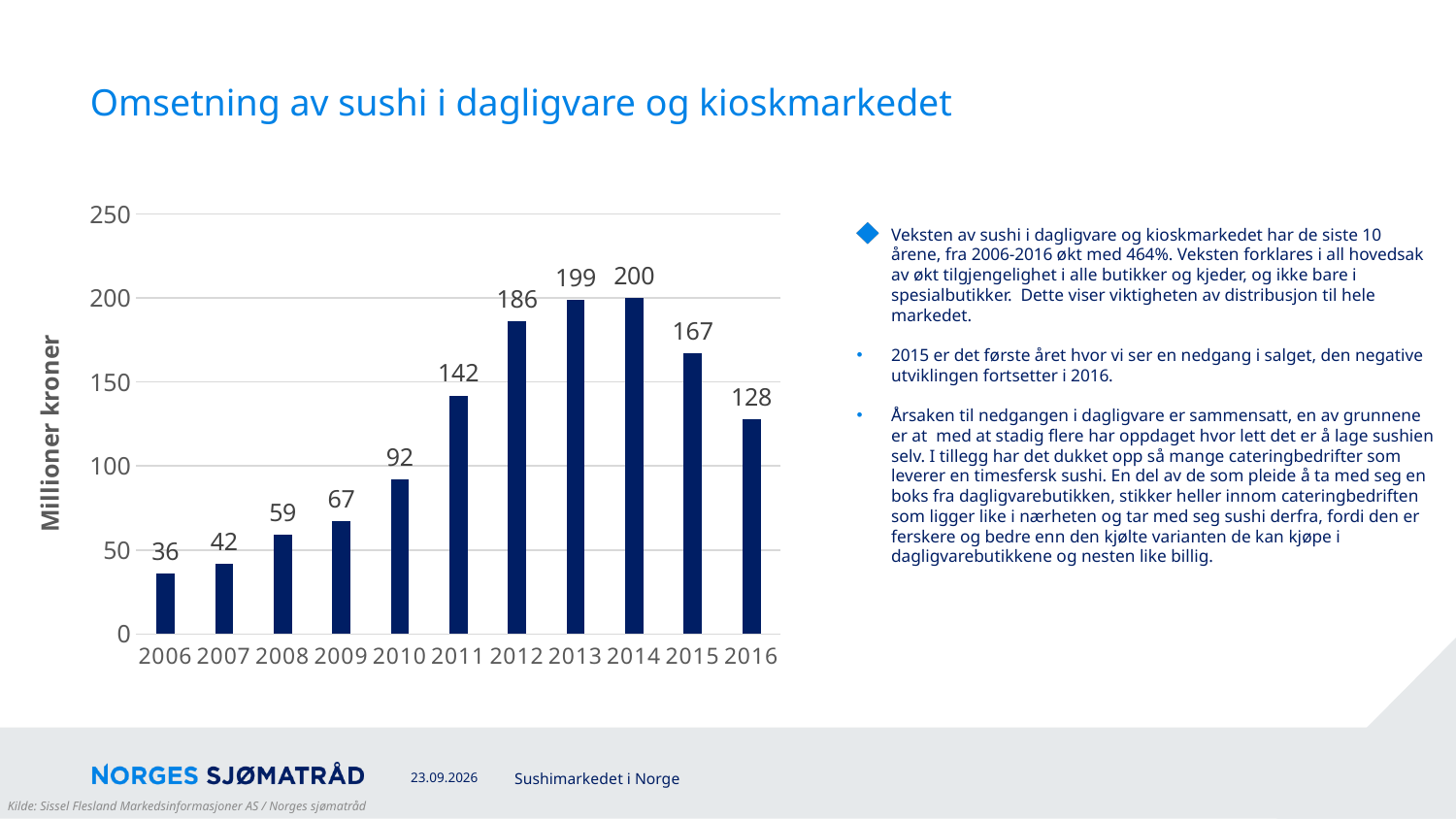
How many years are shown on the x axis? 11 What is the label of the y axis? Millioner kroner Is the value for 2009 greater or less than 100? less What is the difference between the values for 2011 and 2010? 50 What is the value for 2016? 128 Which year has the lowest value? 2006 What is the value for 2012? 186 Which is larger, the value for 2015 or the value for 2011? 2015 What is the value for 2006? 36 What is the difference between the values for 2014 and 2016? 72 What kind of chart is shown on the slide? bar chart Which year has the highest value? 2014